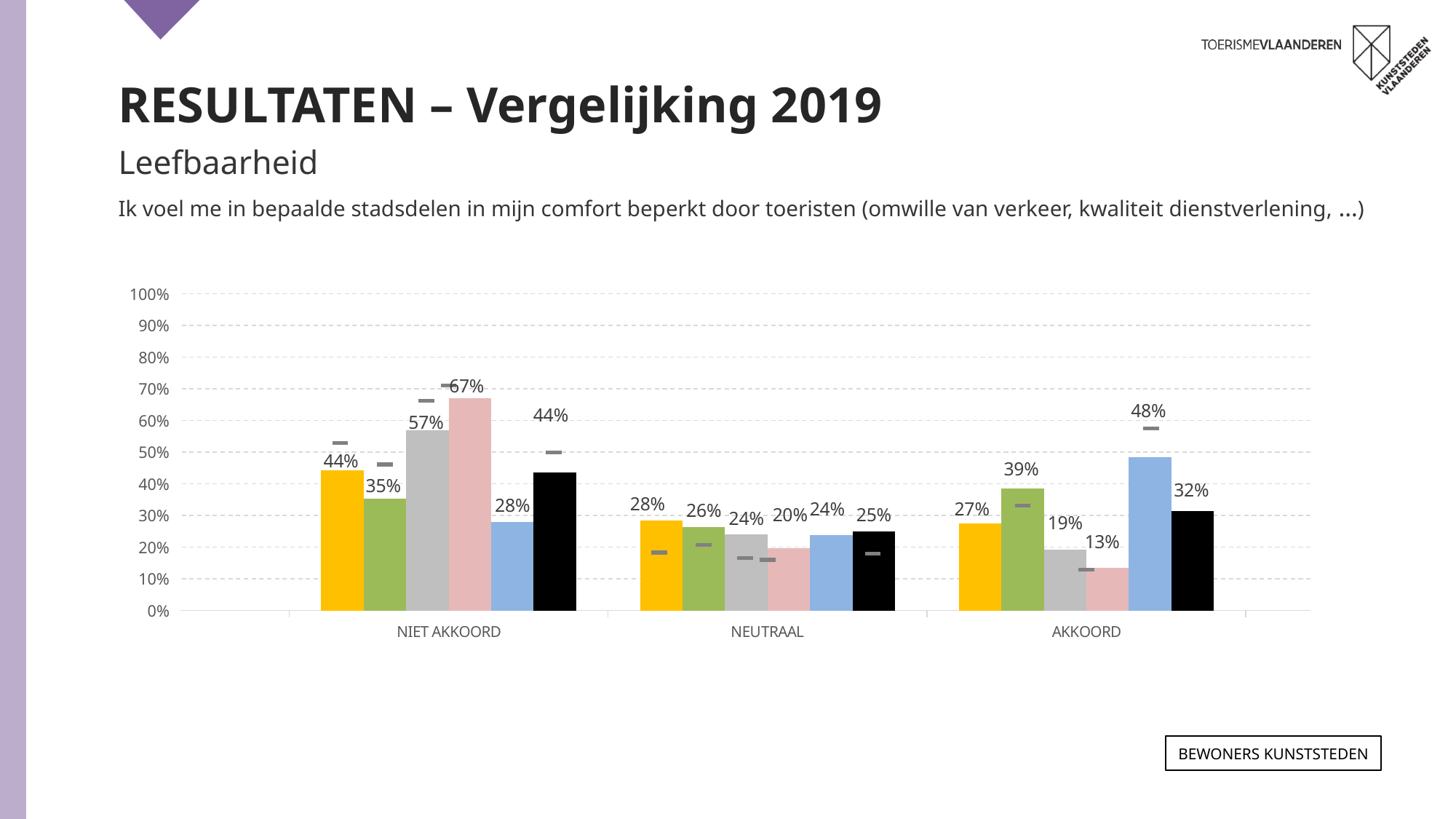
What kind of chart is shown on the slide? bar chart What is the value of the grey bar in the NIET AKKOORD category? 57% What is the value of the blue bar in the AKKOORD category? 48% What is the difference between the pink bar and the blue bar in the NIET AKKOORD category? 39 percentage points How many categories are shown on the x axis of the chart? 3 Which bar is the lowest in the AKKOORD category? the pink bar (13%) What is the x-axis label of the middle category group? NEUTRAAL Which is larger in the AKKOORD category, the green bar or the black bar? the green bar What is the value of the pink bar in the NIET AKKOORD category? 67% Is the value of the black bar in the NIET AKKOORD category greater or less than 40%? greater Which bar is the highest in the NIET AKKOORD category? the pink bar (67%) What is the value of the yellow bar in the NEUTRAAL category? 28%